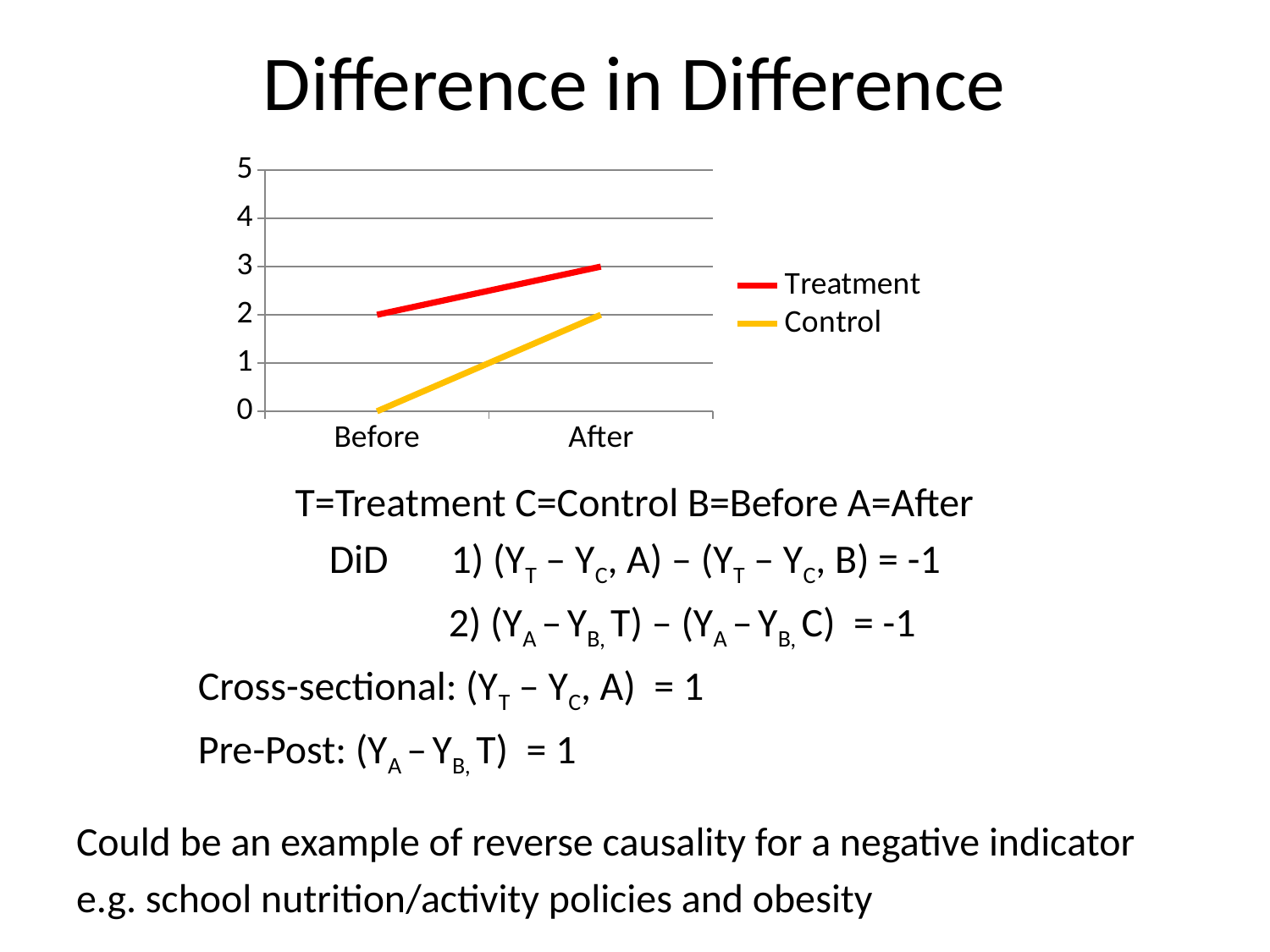
What is the value of the Treatment series at After? 3 What is the difference between the Treatment and Control values at Before? 2 What is the value of the Control series at Before? 0 How many series does the chart's legend list? 2 Which series has the higher value at After, Treatment or Control? Treatment By how much does the Control series increase from Before to After? 2 What is the value of the Control series at After? 2 Does the Control series rise or fall from Before to After? rise What is the value of the Treatment series at Before? 2 What colour is the line for the Treatment series? red How many categories are shown on the x axis of the chart? 2 What kind of chart is shown on the slide? line chart